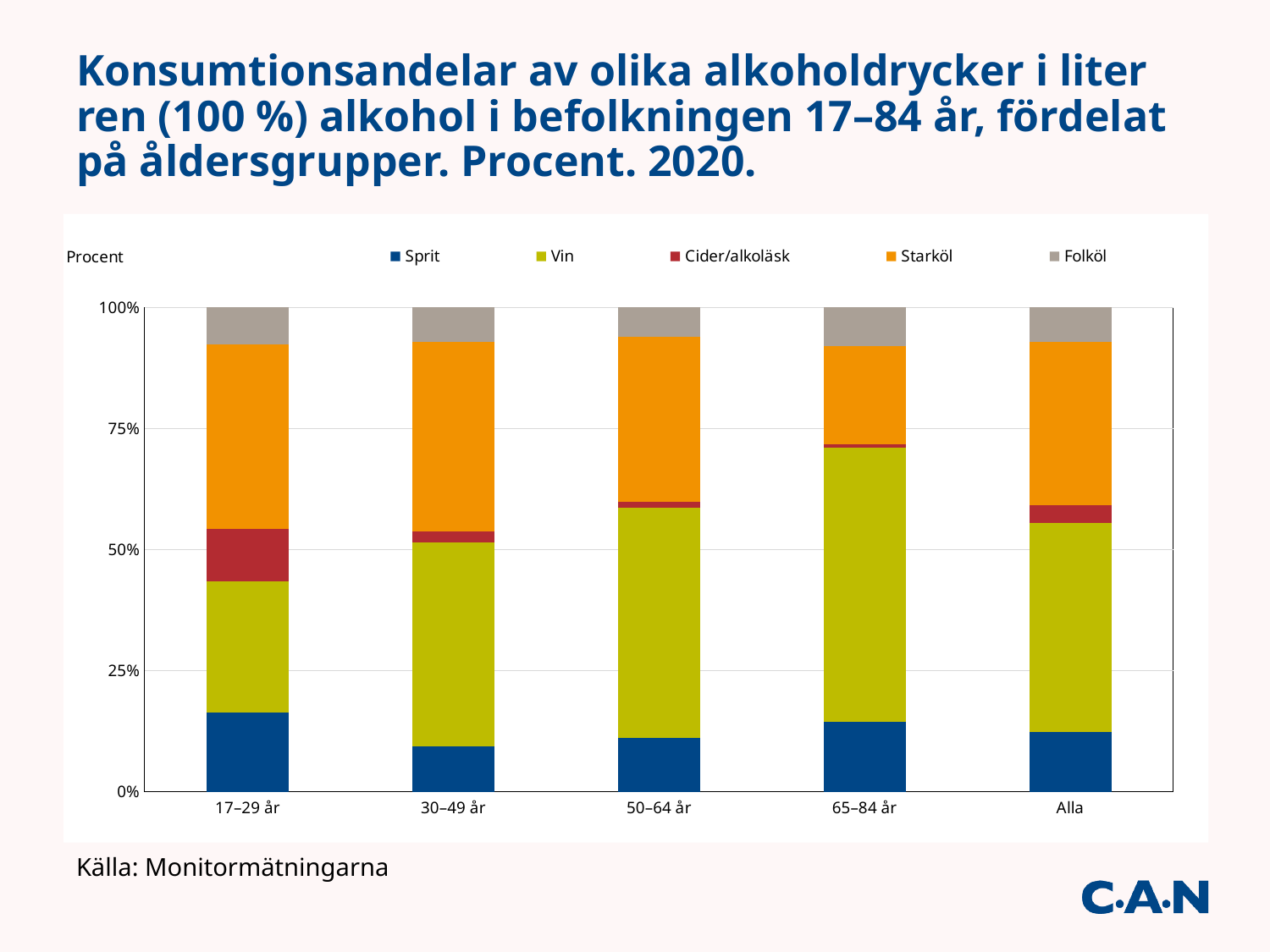
Which age group has the largest share for Vin? 65–84 år What is the source given below the chart? Monitormätningarna Which age group has the largest share for Cider/alkoläsk? 17–29 år How many series does the legend list? 5 Which age group has the smallest share for Starköl? 65–84 år Which series is shown in blue at the bottom of each bar? Sprit Is the Vin share for 65–84 år greater or less than 50%? greater What kind of chart is shown on the slide? Stacked bar chart Which age group has the largest share for Sprit? 17–29 år Is the Sprit share for 17–29 år greater or less than 25%? less Which is larger, the Cider/alkoläsk share for 17–29 år or for 65–84 år? 17–29 år How many age-group categories are shown along the x axis? 5